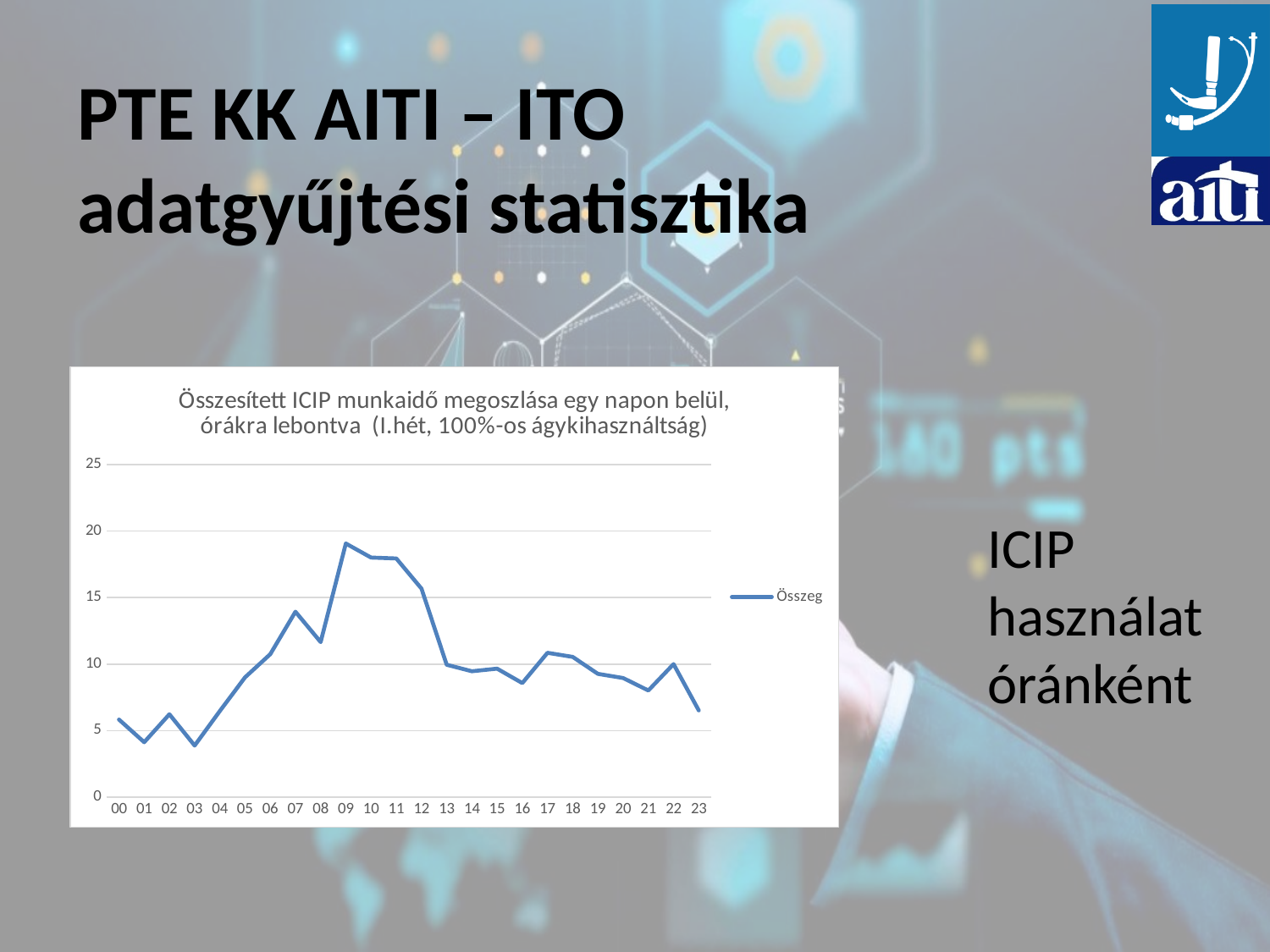
Is the value at hour 16 greater or less than 10? less Is the value at hour 03 greater or less than 5? less What is the name of the series shown in the legend? Összeg At which hour does the Összeg line reach its highest value? 09 Is the value at hour 09 greater or less than 15? greater Does the Összeg line rise or fall between hour 09 and hour 13? fall What kind of chart is shown on the slide? line chart How many series does the legend list? 1 How many hourly points are plotted along the x axis? 24 Which hour has the larger value, 05 or 01? 05 Which hour has the larger value, 09 or 13? 09